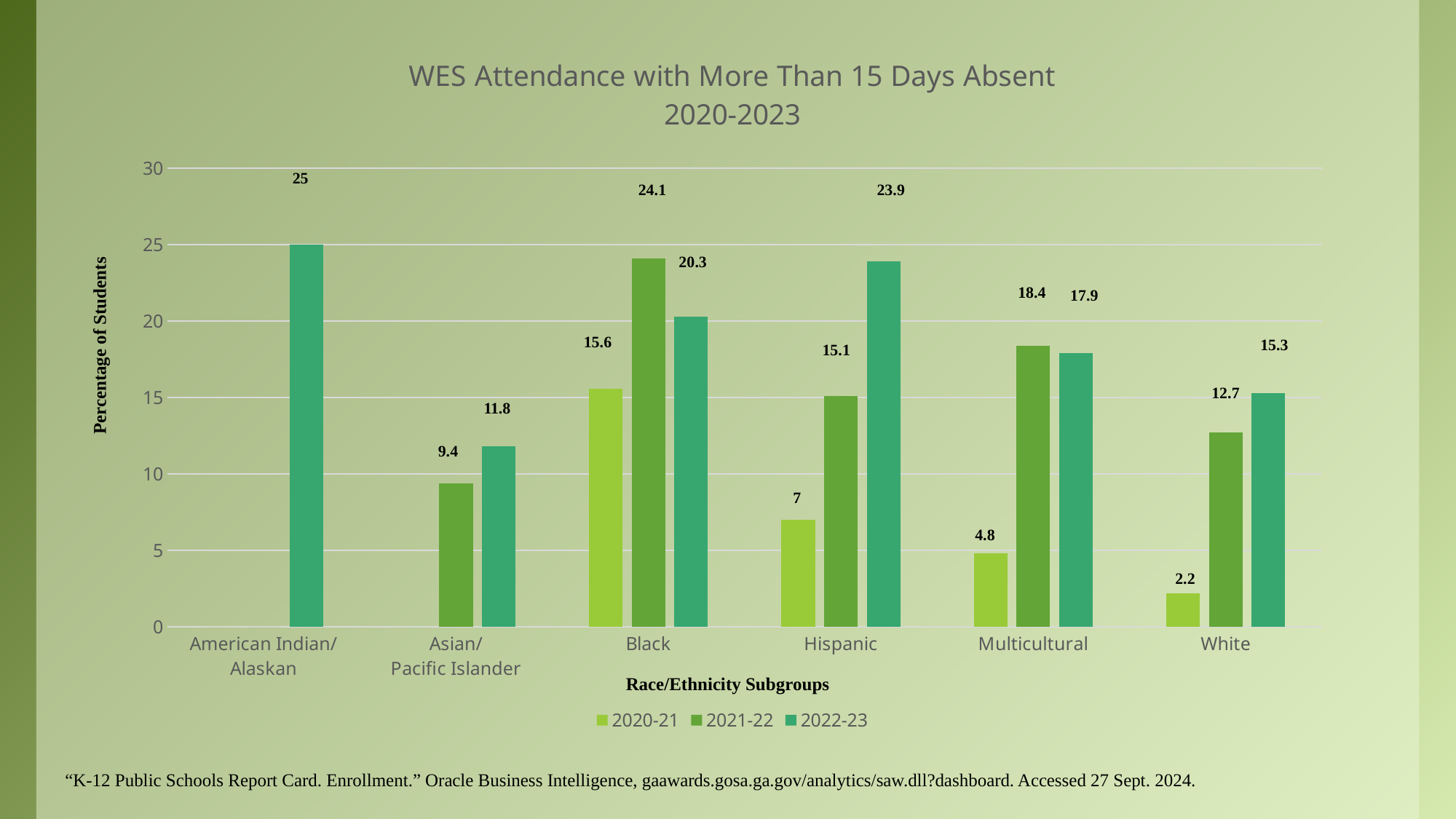
Do the values for Hispanic rise or fall from 2020-21 to 2022-23? Rise What is the 2022-23 value for Hispanic? 23.9 What is the 2021-22 value for Black? 24.1 Which is larger for Multicultural: the 2021-22 value or the 2022-23 value? 2021-22 What is the 2022-23 value for American Indian/Alaskan? 25 Which category has the lowest 2022-23 value? Asian/Pacific Islander How many race/ethnicity subgroups are shown on the x axis? 6 What is the difference between the 2021-22 and 2022-23 values for Black? 3.8 What is the 2020-21 value for White? 2.2 What kind of chart is shown? Bar chart Which category has the highest 2020-21 value? Black How many series does the legend list? 3